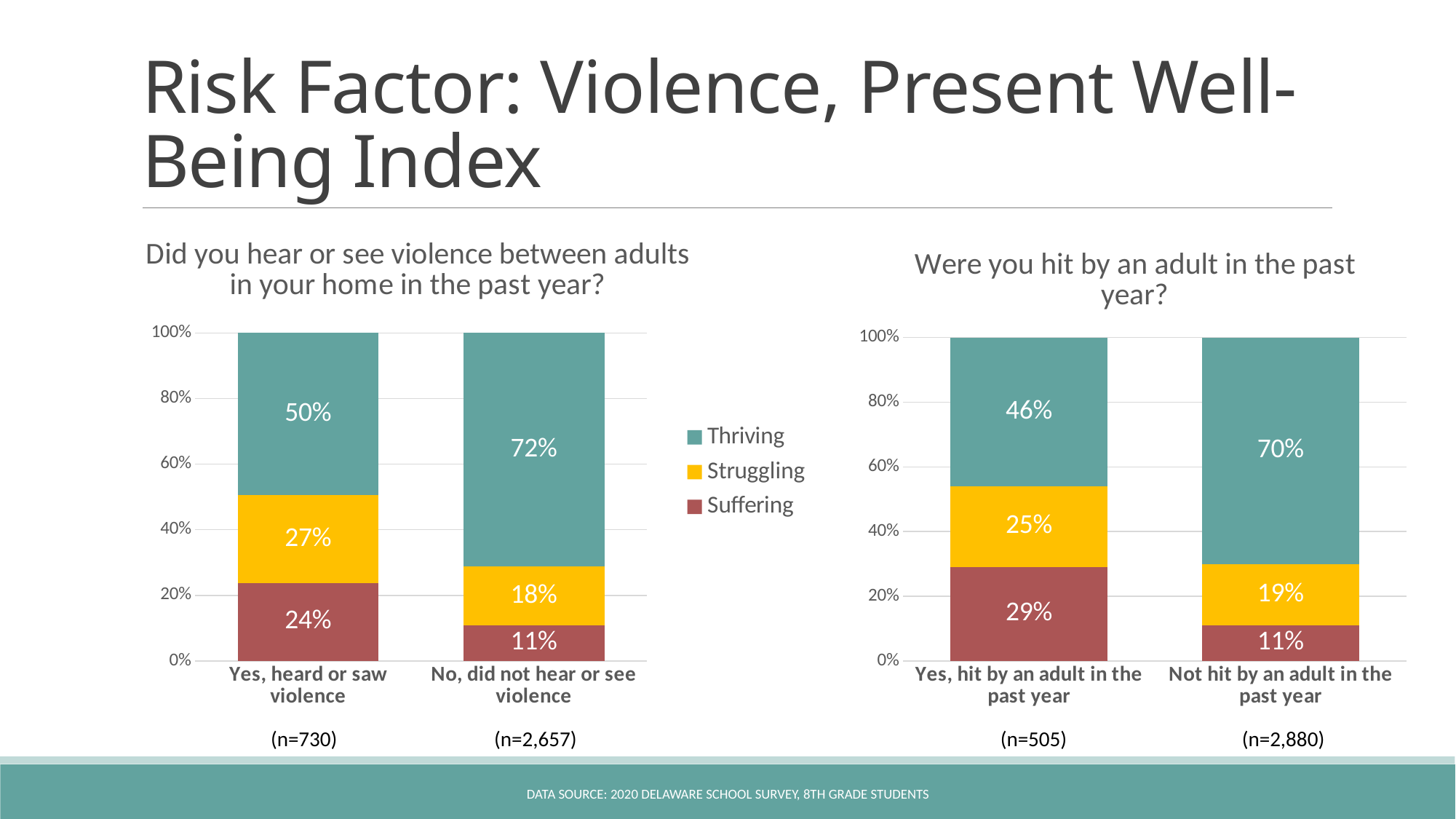
In the chart titled 'Were you hit by an adult in the past year?', what is the Struggling value for 'Yes, hit by an adult in the past year'? 25% In the chart titled 'Did you hear or see violence between adults in your home in the past year?', what is the sample size shown for 'No, did not hear or see violence'? n=2,657 How many categories are shown in the chart titled 'Were you hit by an adult in the past year?' 2 In the chart titled 'Did you hear or see violence between adults in your home in the past year?', which category has the higher Suffering value? Yes, heard or saw violence How many series does the legend list for the charts on the slide? 3 In the chart titled 'Were you hit by an adult in the past year?', which category has the higher Thriving value? Not hit by an adult in the past year In the chart titled 'Were you hit by an adult in the past year?', what is the Thriving value for 'Not hit by an adult in the past year'? 70% In the chart titled 'Did you hear or see violence between adults in your home in the past year?', what is the Thriving value for 'Yes, heard or saw violence'? 50% What kind of chart is the chart titled 'Did you hear or see violence between adults in your home in the past year?' Stacked bar chart In the chart titled 'Were you hit by an adult in the past year?', what is the difference between the Suffering values for the two categories? 18% In the chart titled 'Did you hear or see violence between adults in your home in the past year?', what is the Suffering value for 'No, did not hear or see violence'? 11% In the chart titled 'Did you hear or see violence between adults in your home in the past year?', what is the difference between the Thriving values for the two categories? 22%